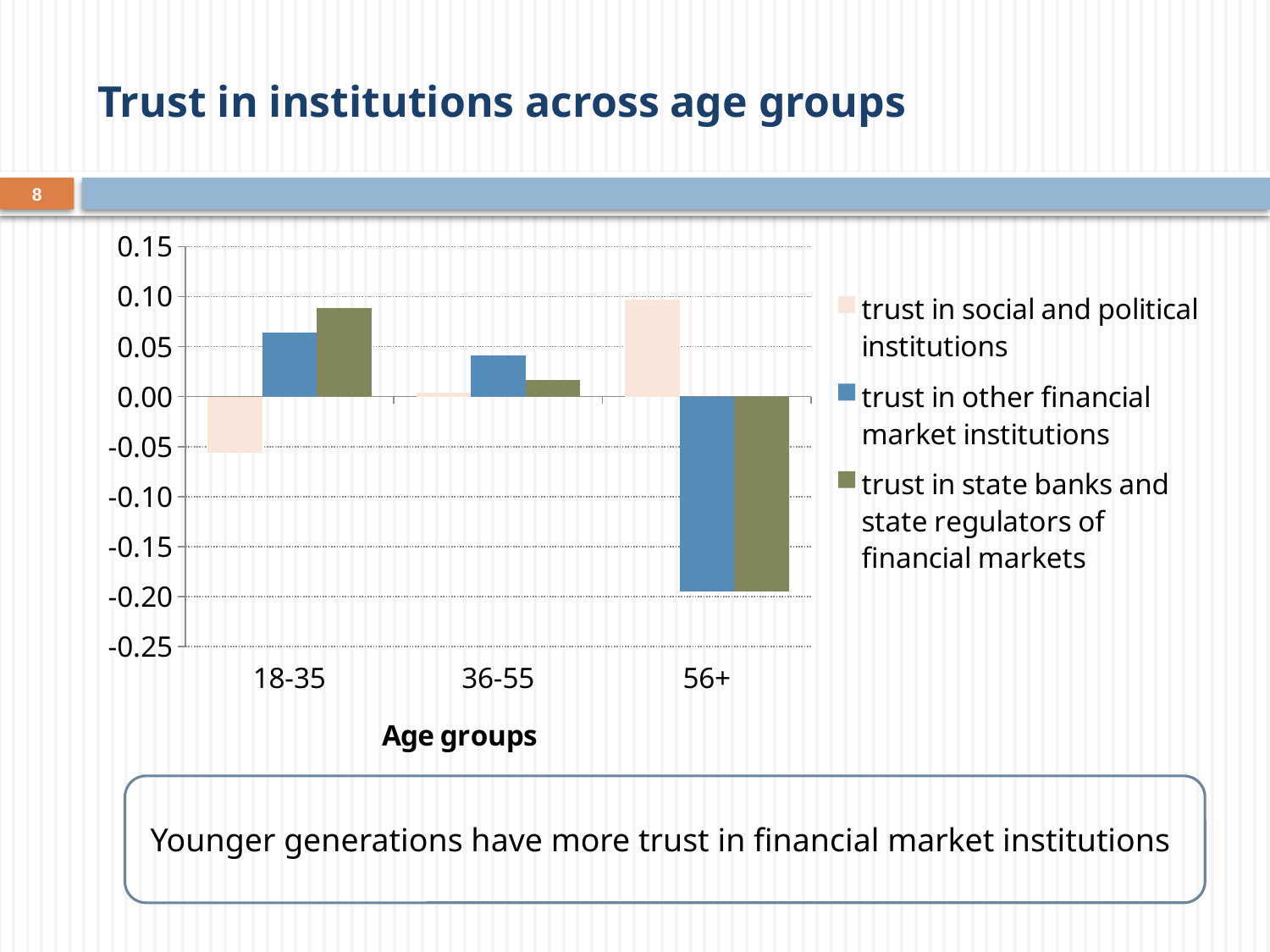
Is the value for trust in state banks and state regulators of financial markets for the 18-35 age group greater or less than 0.05? greater Is the value for trust in other financial market institutions for the 56+ age group greater or less than -0.15? less What kind of chart is shown on the slide? bar chart Which age group has the highest value for trust in social and political institutions? 56+ Which age group has the highest value for trust in state banks and state regulators of financial markets? 18-35 Which age group has the lowest value for trust in other financial market institutions? 56+ Do the values for trust in other financial market institutions rise or fall from the 18-35 group to the 56+ group? fall What is the title of the x axis of the chart? Age groups How many age groups are shown on the x axis of the chart? 3 For the 18-35 age group, which is larger: trust in other financial market institutions or trust in state banks and state regulators of financial markets? trust in state banks and state regulators of financial markets For the 36-55 age group, which is larger: trust in other financial market institutions or trust in state banks and state regulators of financial markets? trust in other financial market institutions How many series does the chart's legend list? 3